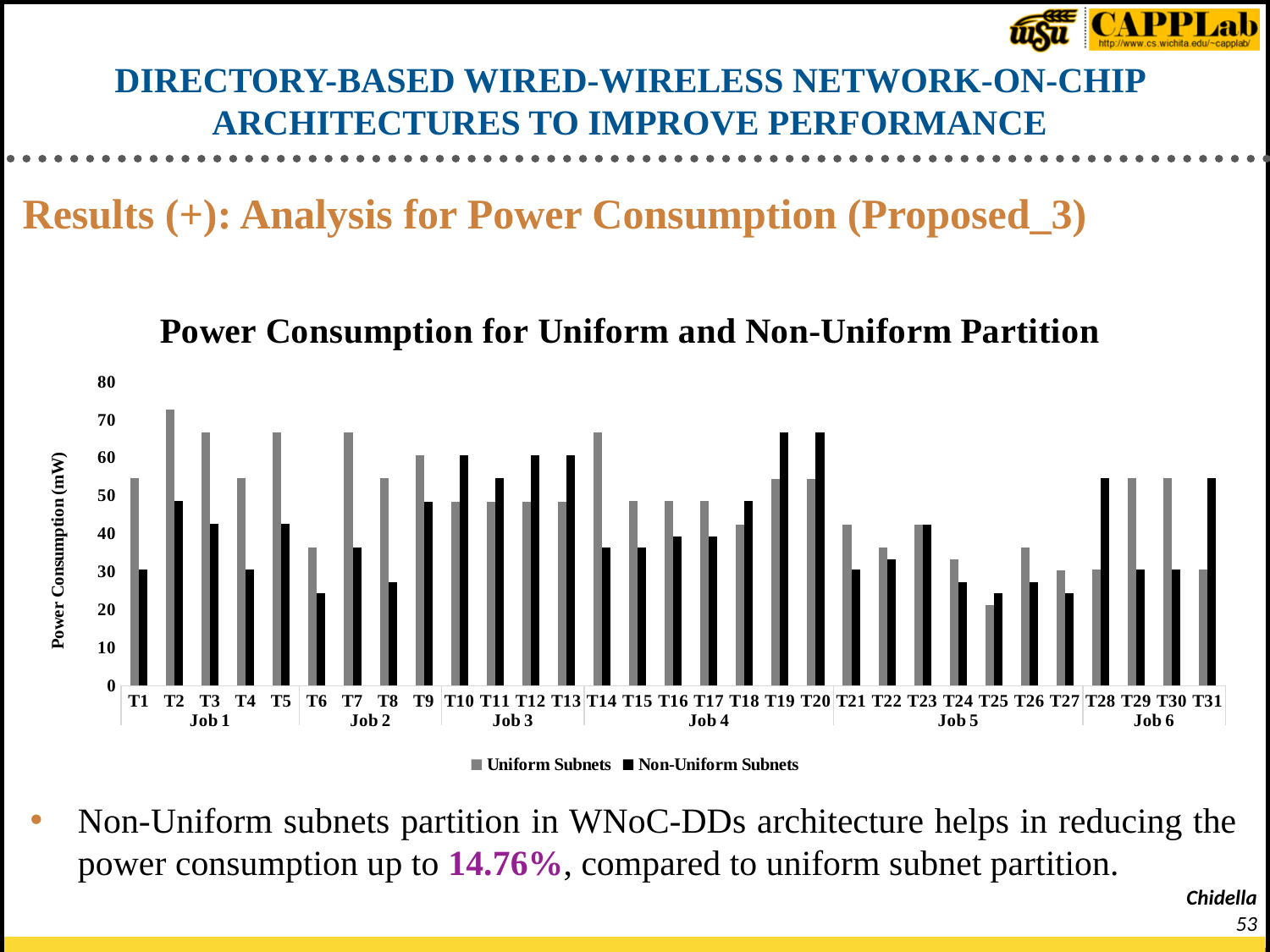
How many series does the legend list? 2 What is the title of the chart? Power Consumption for Uniform and Non-Uniform Partition Which task has the highest Uniform Subnets power consumption? T2 How many job groups are shown on the x axis? 6 What kind of chart is shown on the slide? bar chart Which task has the lowest Uniform Subnets power consumption? T25 For T1, which is larger: Uniform Subnets or Non-Uniform Subnets? Uniform Subnets How many tasks (T1 to T31) are shown on the x axis? 31 Is the Non-Uniform Subnets value for T19 greater or less than 60? greater Is the Non-Uniform Subnets value for T6 greater or less than 30? less For T10, which is larger: Uniform Subnets or Non-Uniform Subnets? Non-Uniform Subnets Is the Uniform Subnets value for T2 greater or less than 70? greater